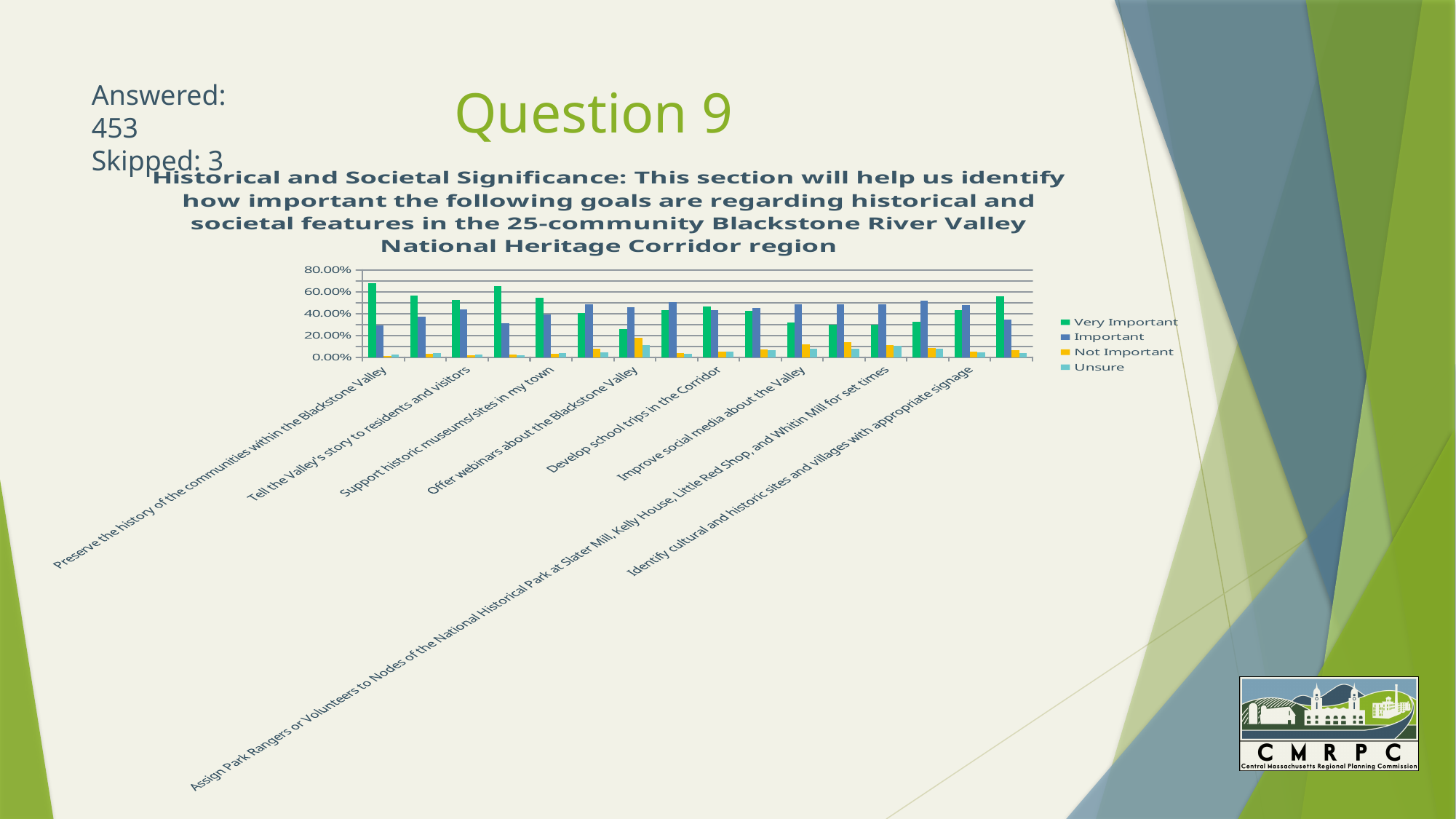
What are the four series listed in the chart's legend? Very Important, Important, Not Important, Unsure For 'Preserve the history of the communities within the Blackstone Valley', which is larger: 'Very Important' or 'Important'? Very Important For 'Improve social media about the Valley', which is larger: 'Important' or 'Very Important'? Important What kind of chart is shown on the slide? bar chart For 'Offer webinars about the Blackstone Valley', which is larger: 'Important' or 'Very Important'? Important How many series does the chart's legend list? 4 Is the 'Not Important' value for 'Preserve the history of the communities within the Blackstone Valley' greater or less than 20.00%? less Is the 'Very Important' value for 'Tell the Valley's story to residents and visitors' greater or less than 40.00%? greater Is the 'Very Important' value for 'Preserve the history of the communities within the Blackstone Valley' greater or less than 60.00%? greater Which colour represents the 'Very Important' series in the chart? green